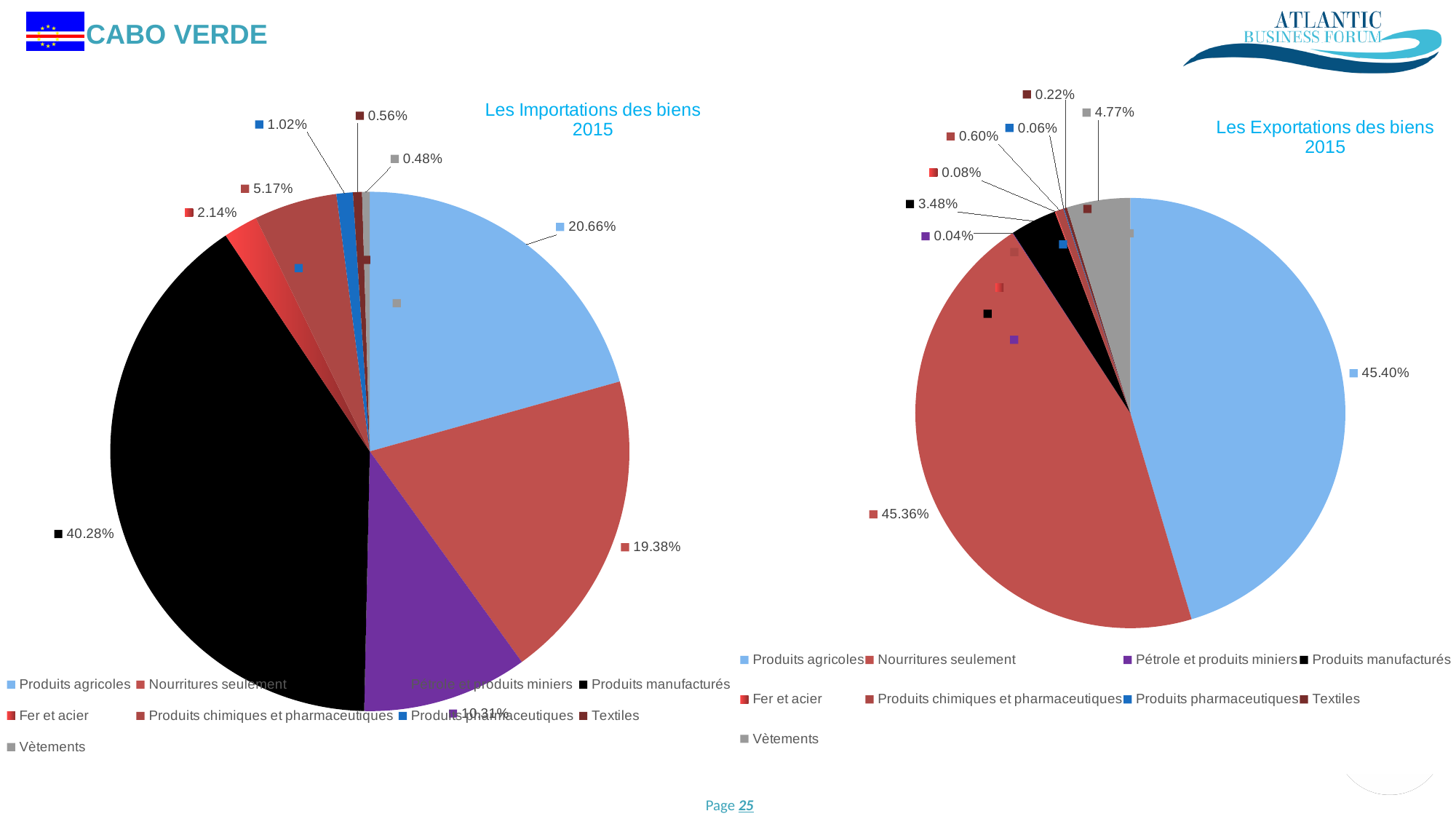
What type of chart is 'Les Importations des biens 2015'? Pie chart In the 'Les Importations des biens 2015' chart, which category has the largest slice? Produits manufacturés In the 'Les Exportations des biens 2015' chart, which is larger: Vètements or Produits manufacturés? Vètements In the 'Les Importations des biens 2015' chart, what share is labelled for Produits manufacturés? 40.28% In the 'Les Importations des biens 2015' chart, which is larger: Fer et acier or Produits chimiques et pharmaceutiques? Produits chimiques et pharmaceutiques In the 'Les Importations des biens 2015' chart, which category has the smallest slice? Vètements In the 'Les Exportations des biens 2015' chart, what share is labelled for Vètements? 4.77% In the 'Les Importations des biens 2015' chart, what share is labelled for Produits agricoles? 20.66% In the 'Les Exportations des biens 2015' chart, what share is labelled for Produits manufacturés? 3.48% In the 'Les Exportations des biens 2015' chart, what is the difference between the shares for Produits agricoles and Nourritures seulement? 0.04% How many categories does the legend of the 'Les Exportations des biens 2015' chart list? 9 In the 'Les Importations des biens 2015' chart, what is the difference between the shares for Produits agricoles and Nourritures seulement? 1.28%